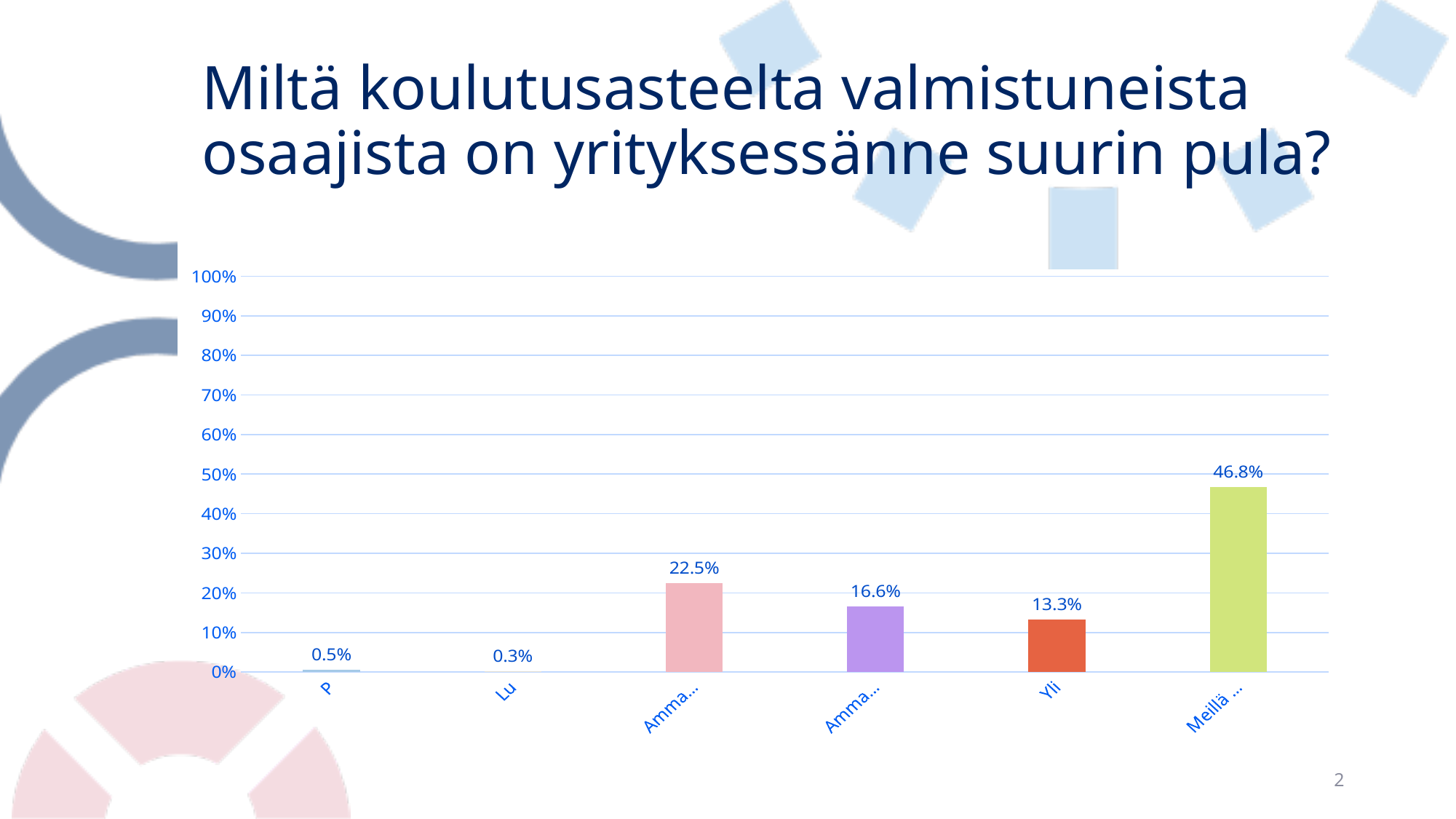
What is the value of the rightmost bar (labelled "Meillä ...")? 46.8% Which is larger, the third bar from the left or the fourth bar from the left? The third bar (22.5%) What is the value for the category labelled "Lu"? 0.3% Is the value of the rightmost bar greater or less than 40%? greater How many bars (categories) does the chart show? 6 What kind of chart is shown on the slide? Bar chart What colour is the tallest bar in the chart? Yellow-green What is the value for the category labelled "Yli"? 13.3% What is the value for the category labelled "P"? 0.5% Which category has the highest value? Meillä ... (the rightmost bar) Which category has the lowest value? Lu What is the difference between the rightmost bar (46.8%) and the "Yli" bar (13.3%)? 33.5 percentage points